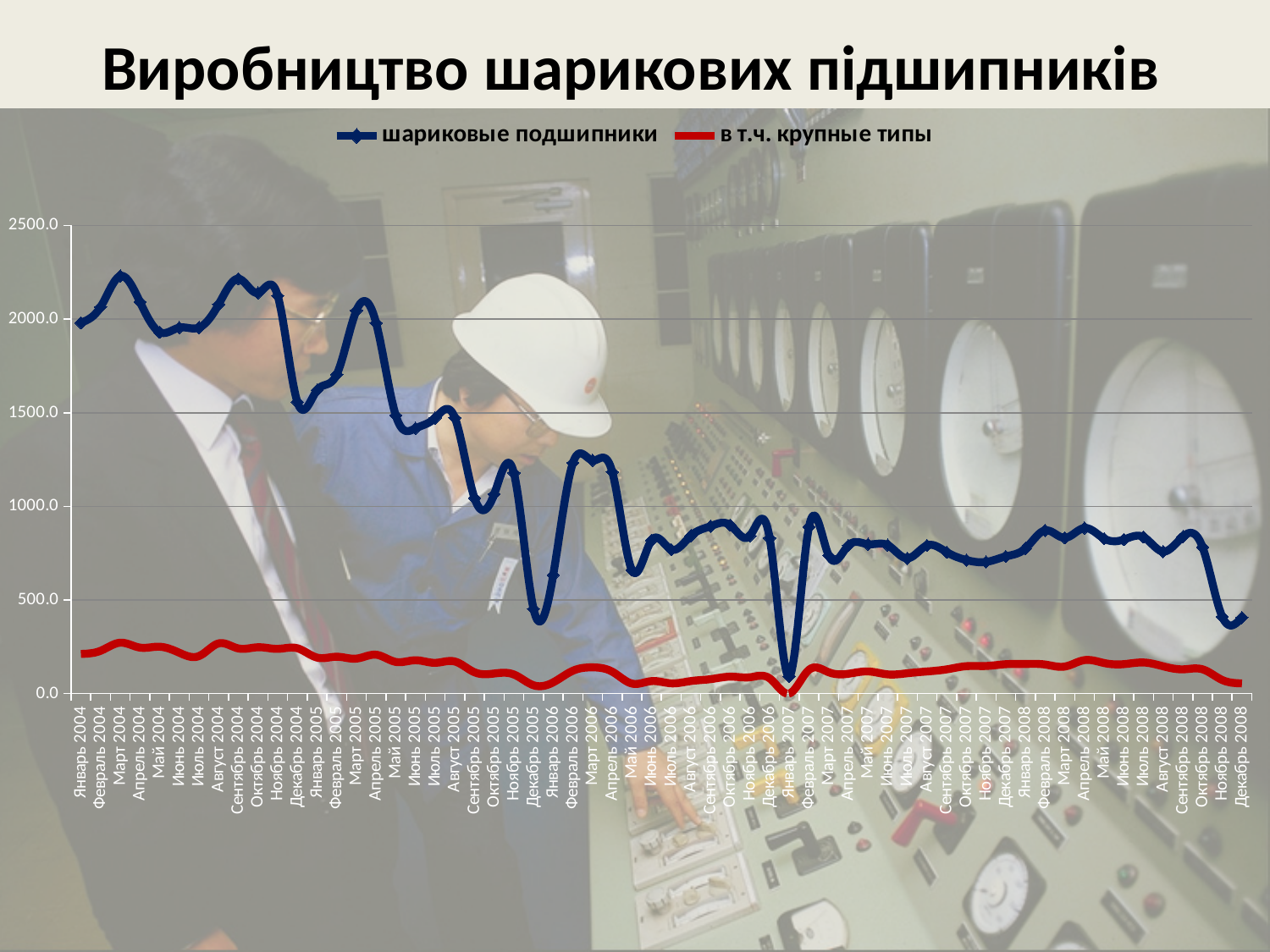
What is the title of the slide chart? Виробництво шарикових підшипників Which series is drawn in red? в т.ч. крупные типы Does the шариковые подшипники series overall rise or fall from Январь 2004 to Декабрь 2008? fall What kind of chart is shown on the slide? line chart How many monthly points are plotted along the x axis (Январь 2004 to Декабрь 2008)? 60 Is the value for шариковые подшипники in Декабрь 2005 greater or less than 500? less In which month is the шариковые подшипники series at its lowest? Январь 2007 Is the value for в т.ч. крупные типы in Январь 2004 greater or less than 500? less Is the value for шариковые подшипники in Декабрь 2008 greater or less than 500? less Which series has the larger value in Март 2004, шариковые подшипники or в т.ч. крупные типы? шариковые подшипники How many series does the legend list? 2